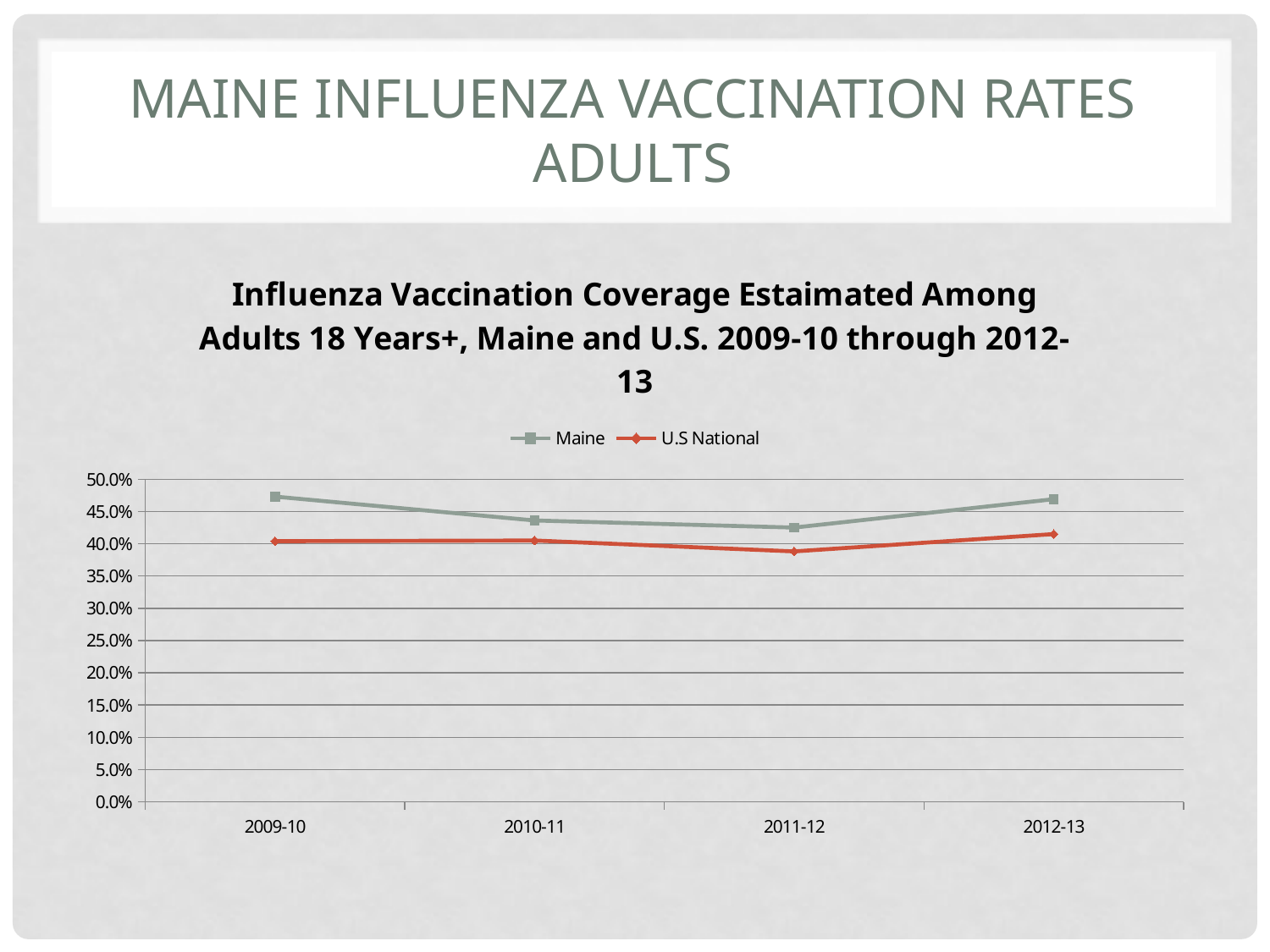
What kind of chart is shown on the slide? line chart In which season is the U.S National vaccination rate highest? 2012-13 How many series does the legend list? 2 In which season is the Maine vaccination rate lowest? 2011-12 Is the Maine value for 2011-12 greater or less than 40.0%? greater Is the U.S National value for 2011-12 greater or less than 40.0%? less Which series is plotted in red with diamond markers? U.S National How many flu seasons are plotted along the x axis? 4 Does the Maine line rise or fall from 2011-12 to 2012-13? rise Is the Maine value for 2009-10 greater or less than 45.0%? greater In which season is the U.S National vaccination rate lowest? 2011-12 Which series has the higher value in 2009-10, Maine or U.S National? Maine